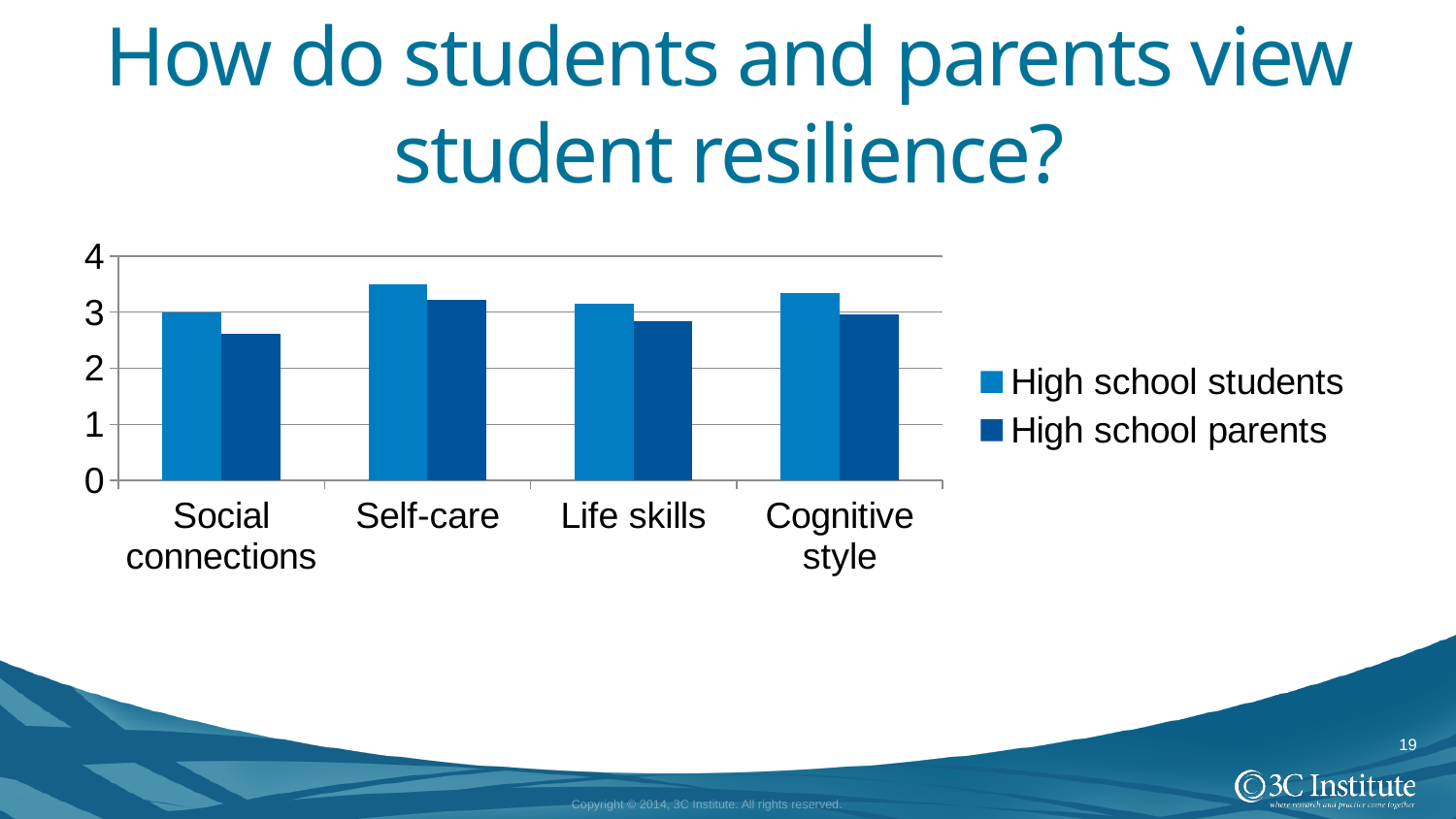
Which category has the lowest value for High school parents? Social connections Which category has the highest value for High school students? Self-care Which category has the highest value for High school parents? Self-care What kind of chart is shown on the slide? bar chart What are the two series named in the chart's legend? High school students and High school parents How many series does the chart's legend list? 2 For Cognitive style, which is larger: the value for High school students or High school parents? High school students How many categories are shown on the x axis of the chart? 4 Is the value for High school parents in Life skills greater or less than 3? less Is the value for High school students in Self-care greater or less than 3? greater Is the value for High school parents in Social connections greater or less than 3? less For Social connections, which is larger: the value for High school students or High school parents? High school students